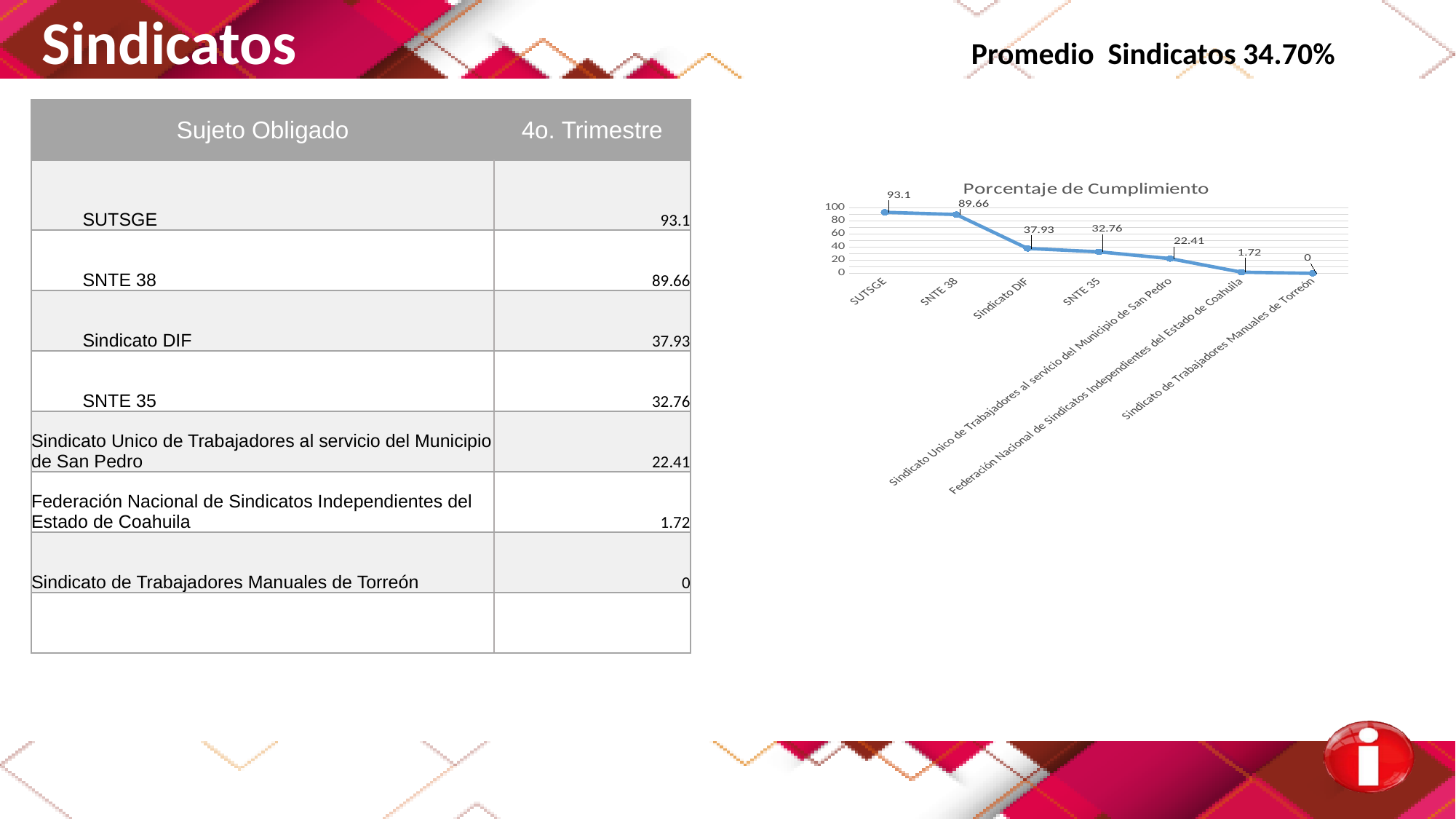
Which category has the lowest value in the Porcentaje de Cumplimiento chart? Sindicato de Trabajadores Manuales de Torreón How many categories are plotted in the Porcentaje de Cumplimiento chart? 7 What kind of chart is the Porcentaje de Cumplimiento chart? line chart What is the value for SUTSGE in the Porcentaje de Cumplimiento chart? 93.1 What is the value for Sindicato de Trabajadores Manuales de Torreón in the chart? 0 Which category has the highest value in the Porcentaje de Cumplimiento chart? SUTSGE Is the value for SNTE 38 in the chart greater or less than 80? greater What is the value for Sindicato DIF in the Porcentaje de Cumplimiento chart? 37.93 Do the values in the Porcentaje de Cumplimiento chart rise or fall from left to right along the x axis? fall What is the title of the chart on the slide? Porcentaje de Cumplimiento What is the difference between the values for SUTSGE and SNTE 38 in the chart? 3.44 Which is larger in the chart, the value for SNTE 35 or the value for Sindicato Unico de Trabajadores al servicio del Municipio de San Pedro? SNTE 35